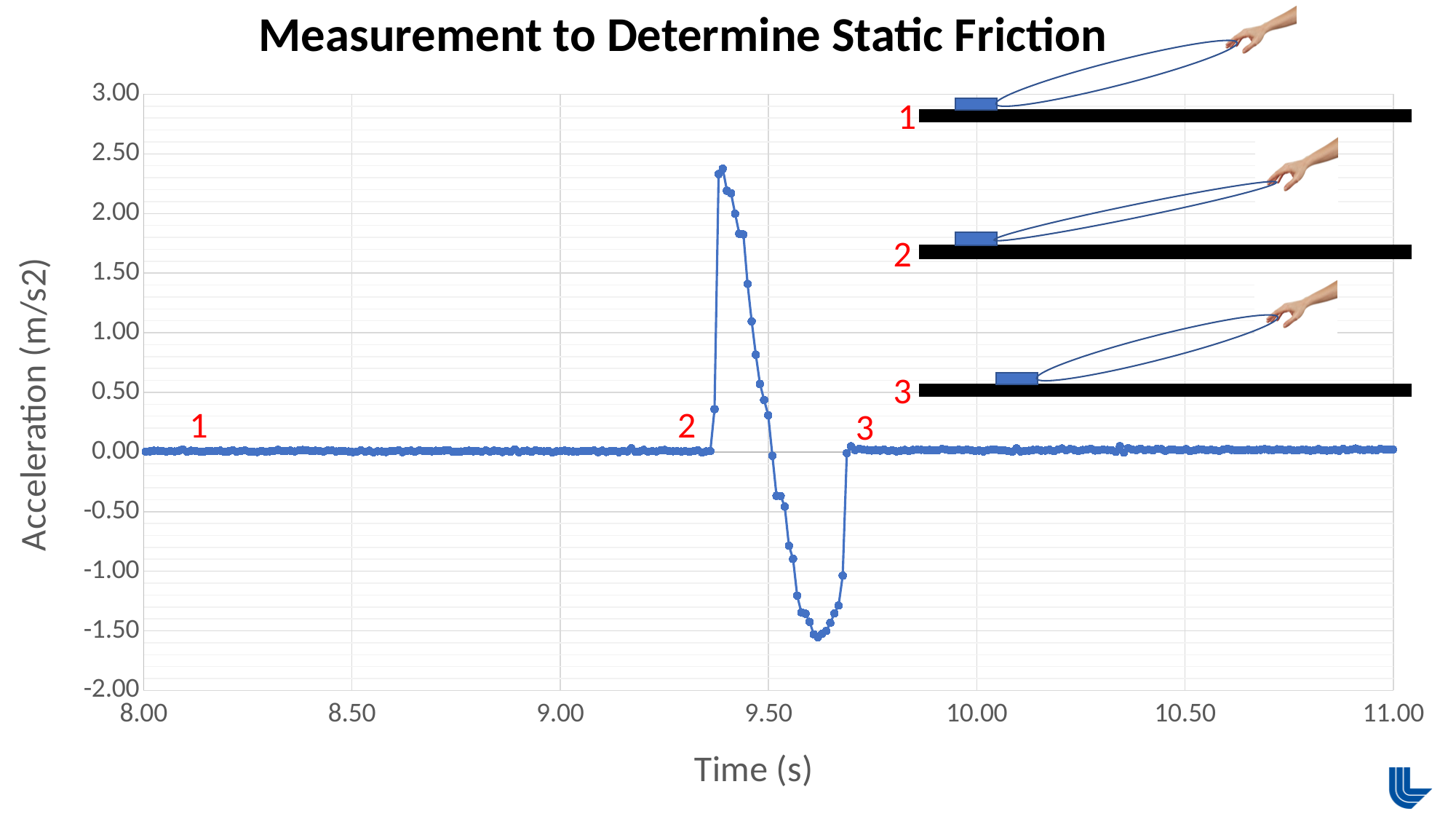
Between time 9.35 s and 9.40 s, does the acceleration rise or fall? rise Is the peak acceleration value greater or less than 2.00? greater What is the title of the chart? Measurement to Determine Static Friction What kind of chart is shown on the slide? line chart What is the label of the vertical axis? Acceleration (m/s2) Is the acceleration at time 8.50 s greater or less than 0.50? less Between time 9.40 s and 9.60 s, does the acceleration rise or fall? fall Does the peak acceleration occur at a time greater or less than 9.50 s? less Which is larger, the acceleration at time 9.40 s or at time 9.60 s? 9.40 s